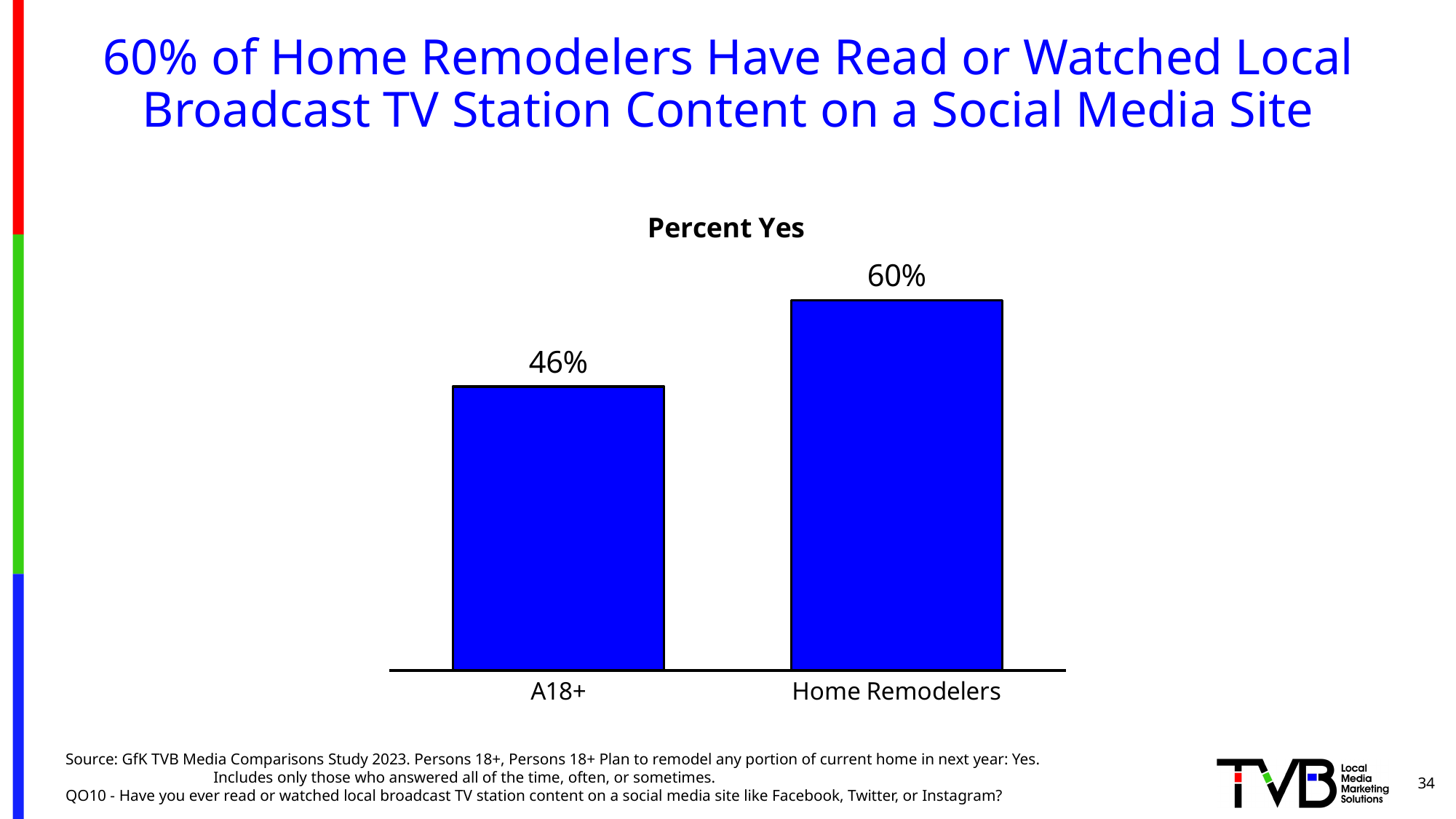
What kind of chart is shown on the slide? bar chart Do the values rise or fall from A18+ to Home Remodelers? rise How many categories are shown in the chart? 2 Which is larger, the value for A18+ or the value for Home Remodelers? Home Remodelers What colour are the bars in the chart? blue Which category has the lowest value? A18+ Which category has the highest value? Home Remodelers What is the value for Home Remodelers? 60% What is the value for A18+? 46% What is the title of the chart? Percent Yes What is the difference between the values for Home Remodelers and A18+? 14%